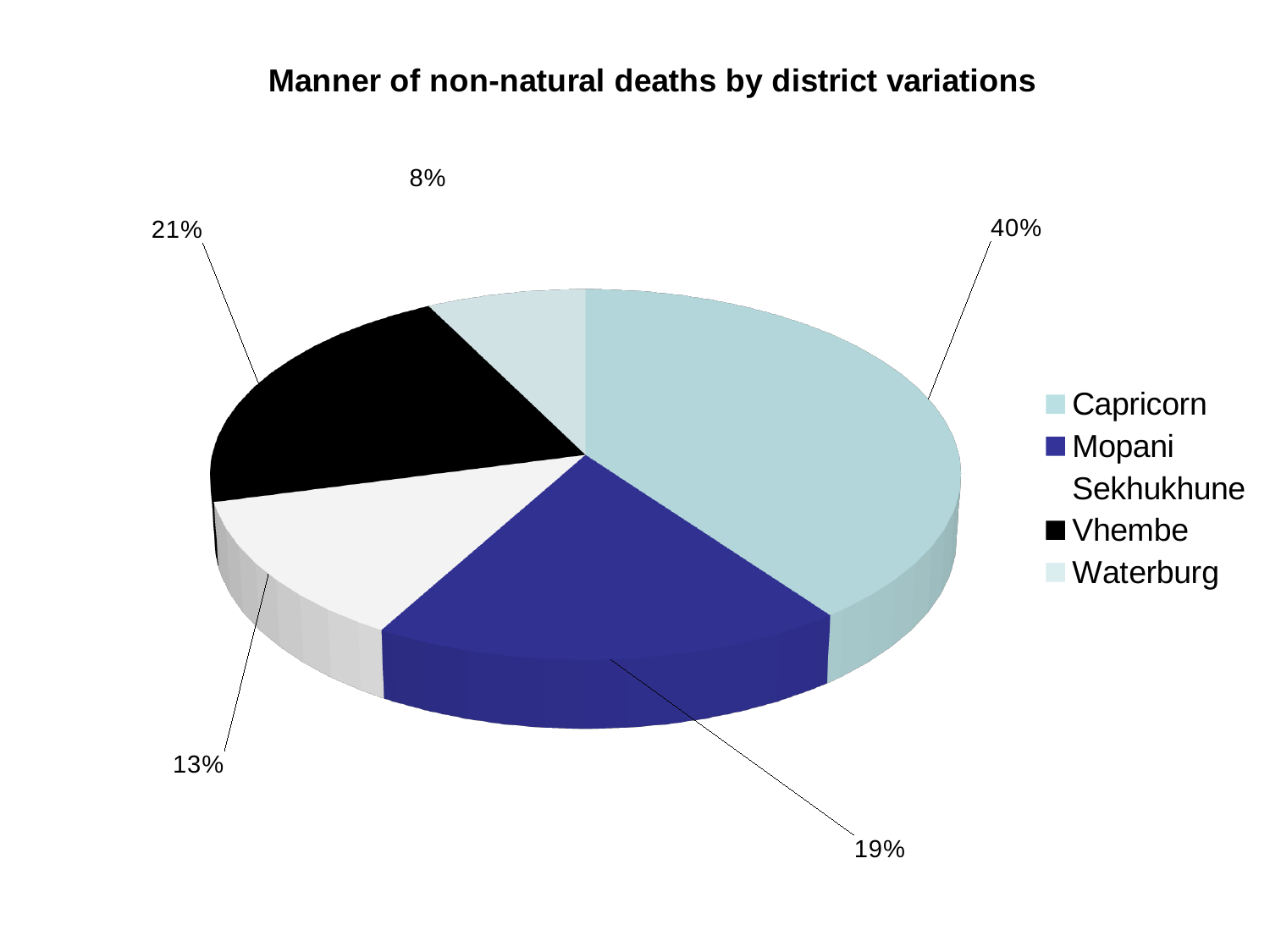
What is the title of the chart? Manner of non-natural deaths by district variations What share of the pie does Capricorn have? 40% What share of the pie does Mopani have? 19% How many districts are shown in the pie chart? 5 What kind of chart is shown on the slide? Pie chart What is the difference in percentage points between Capricorn and Vhembe? 19 What share of the pie does Waterburg have? 8% Which district has the smallest slice of the pie? Waterburg Which district has the largest slice of the pie? Capricorn Which is larger, the share for Vhembe or the share for Mopani? Vhembe